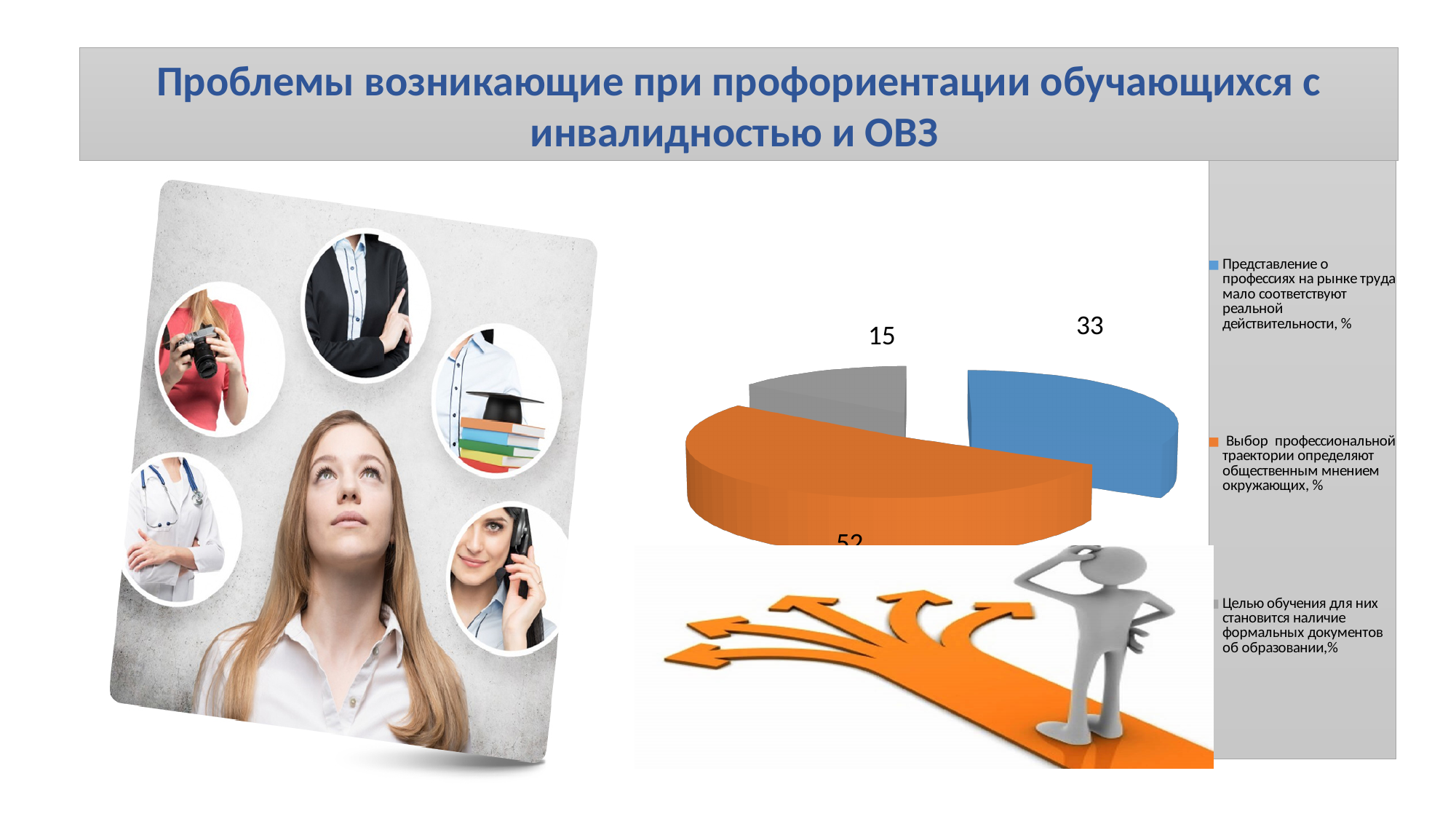
Which category has the largest slice of the pie? Выбор профессиональной траектории определяют общественным мнением окружающих, % Which category has the smallest slice of the pie? Целью обучения для них становится наличие формальных документов об образовании,% What is the difference between the value for "Представление о профессиях на рынке труда мало соответствуют реальной действительности, %" and the value for "Целью обучения для них становится наличие формальных документов об образовании,%"? 18 How many slices does the pie chart have? 3 How many entries does the legend of the pie chart list? 3 What kind of chart is shown on the slide? pie chart Which is larger: the slice for "Представление о профессиях на рынке труда мало соответствуют реальной действительности, %" or the slice for "Целью обучения для них становится наличие формальных документов об образовании,%"? Представление о профессиях на рынке труда мало соответствуют реальной действительности, % What value is shown for the slice "Представление о профессиях на рынке труда мало соответствуют реальной действительности, %"? 33 What colour is the largest slice of the pie chart? orange What colour is the slice for "Представление о профессиях на рынке труда мало соответствуют реальной действительности, %"? blue What value is shown for the slice "Целью обучения для них становится наличие формальных документов об образовании,%"? 15